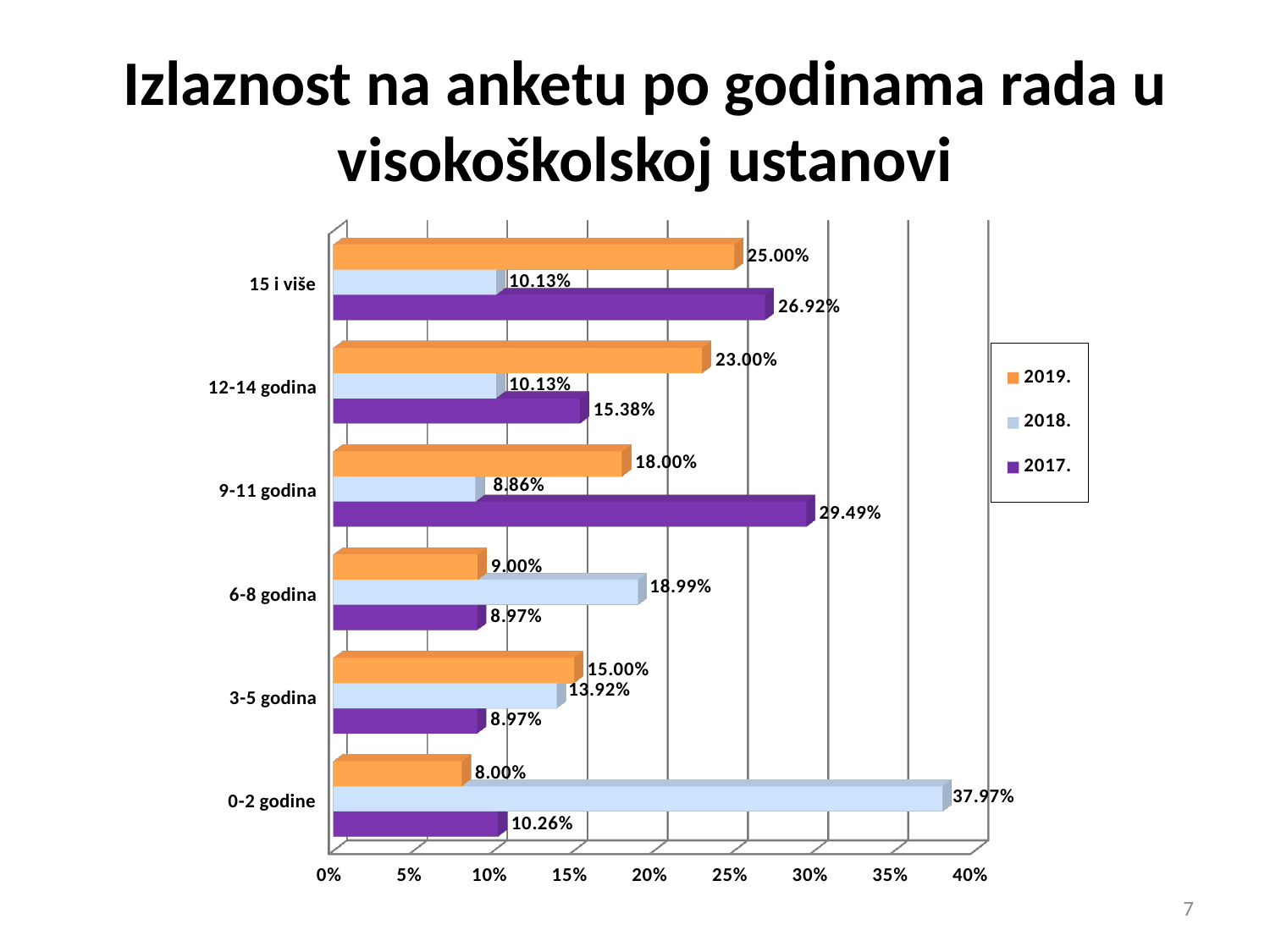
How many categories are shown on the chart? 6 Which category has the lowest value for the 2018. series? 9-11 godina What kind of chart is shown on the slide? Bar chart What is the value for 2017. in the 9-11 godina category? 29.49% What is the value for 2018. in the 0-2 godine category? 37.97% Which category has the highest value for the 2019. series? 15 i više Which colour represents the 2017. series in the legend? Purple In the 6-8 godina category, which series has the larger value, 2018. or 2019.? 2018. How many series does the legend list? 3 What is the value for 2019. in the 15 i više category? 25.00% What is the difference between the 2017. and 2018. values in the 12-14 godina category? 5.25% Is the value for 2017. in the 15 i više category greater or less than 25%? greater